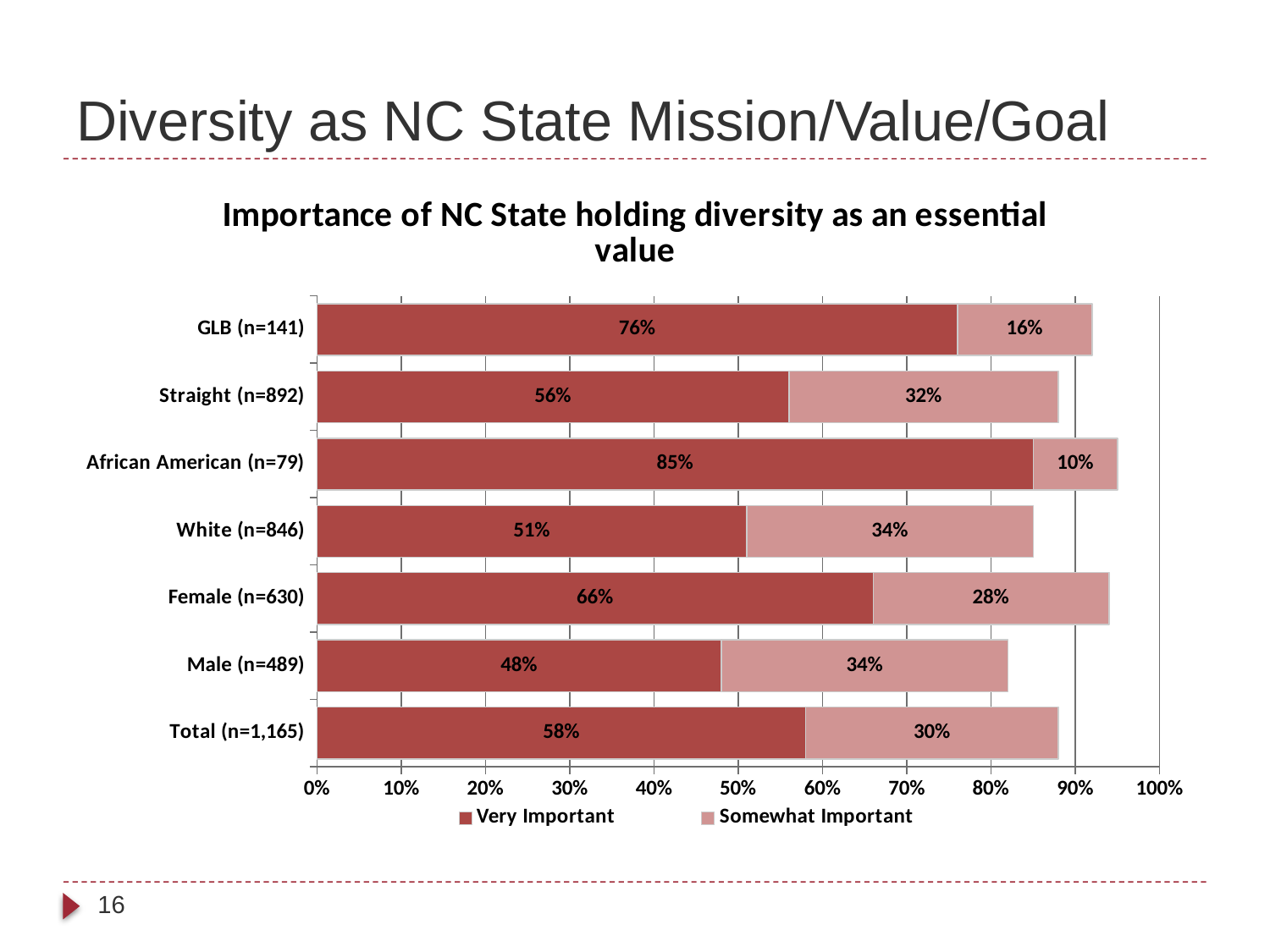
How many categories are shown on the chart? 7 What is the title of the chart? Importance of NC State holding diversity as an essential value How many series does the legend list? 2 What percentage of GLB respondents rated diversity as Very Important? 76% What is the combined total of Very Important and Somewhat Important for Total (n=1,165)? 88% Which category has the highest Very Important percentage? African American (n=79) What kind of chart is shown on the slide? Stacked bar chart Which is larger, the Very Important value for White or for Straight? Straight Which category has the lowest Very Important percentage? Male (n=489) What is the combined total of Very Important and Somewhat Important for African American (n=79)? 95% What is the difference between the Very Important percentages for Female and Male? 18% What is the Somewhat Important value for Straight (n=892)? 32%